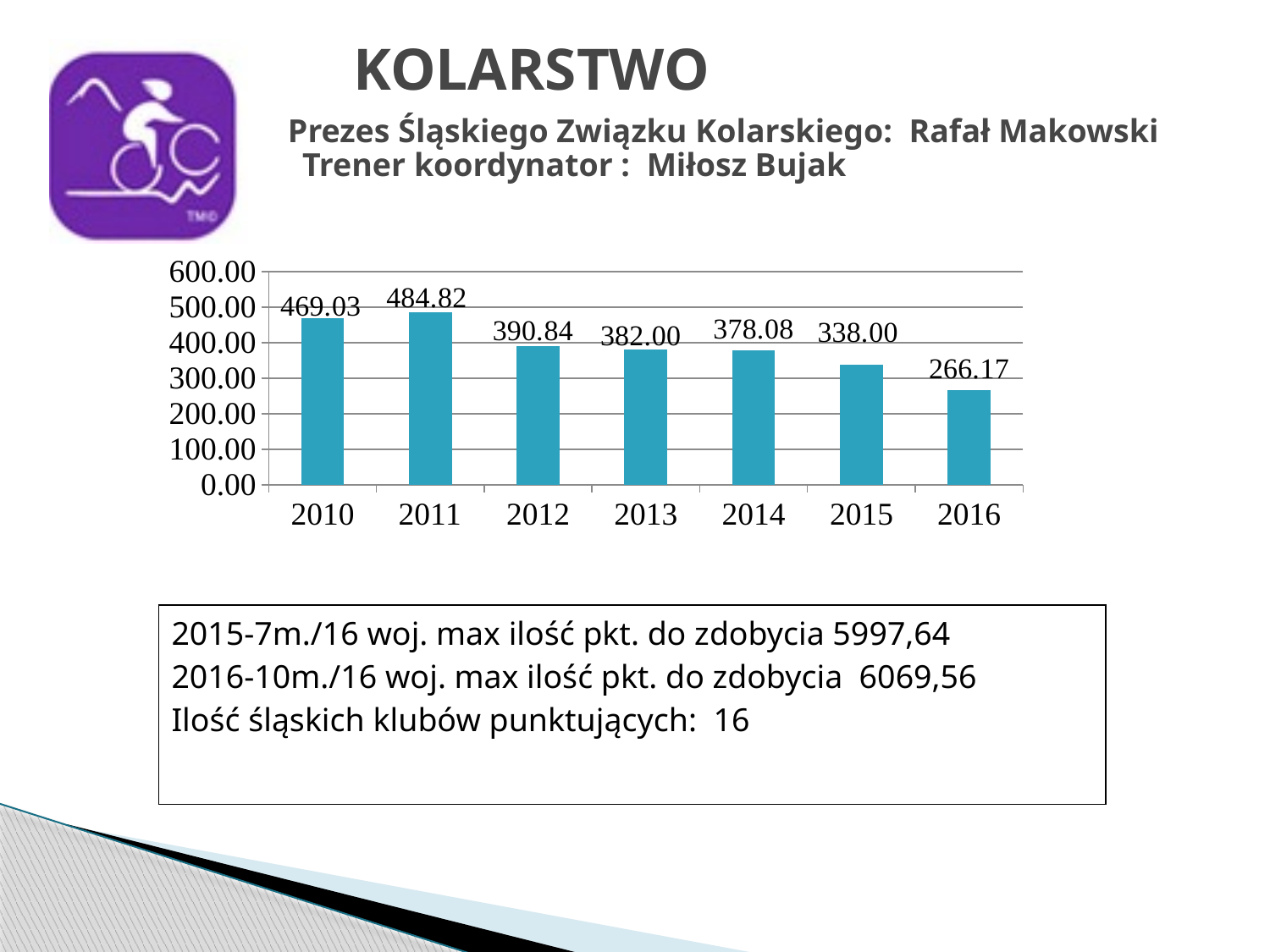
What is the value for 2016? 266.17 What is the difference between the values for 2011 and 2010? 15.79 Which year has the highest value? 2011 What kind of chart is shown on the slide? bar chart How many years are shown on the x axis? 7 What is the difference between the values for 2015 and 2016? 71.83 Which year has the lowest value? 2016 What is the value for 2013? 382.00 Which is larger, the value for 2012 or the value for 2014? 2012 What is the value for 2010? 469.03 Do the values generally rise or fall from 2011 to 2016? fall Is the value for 2015 greater or less than 400.00? less